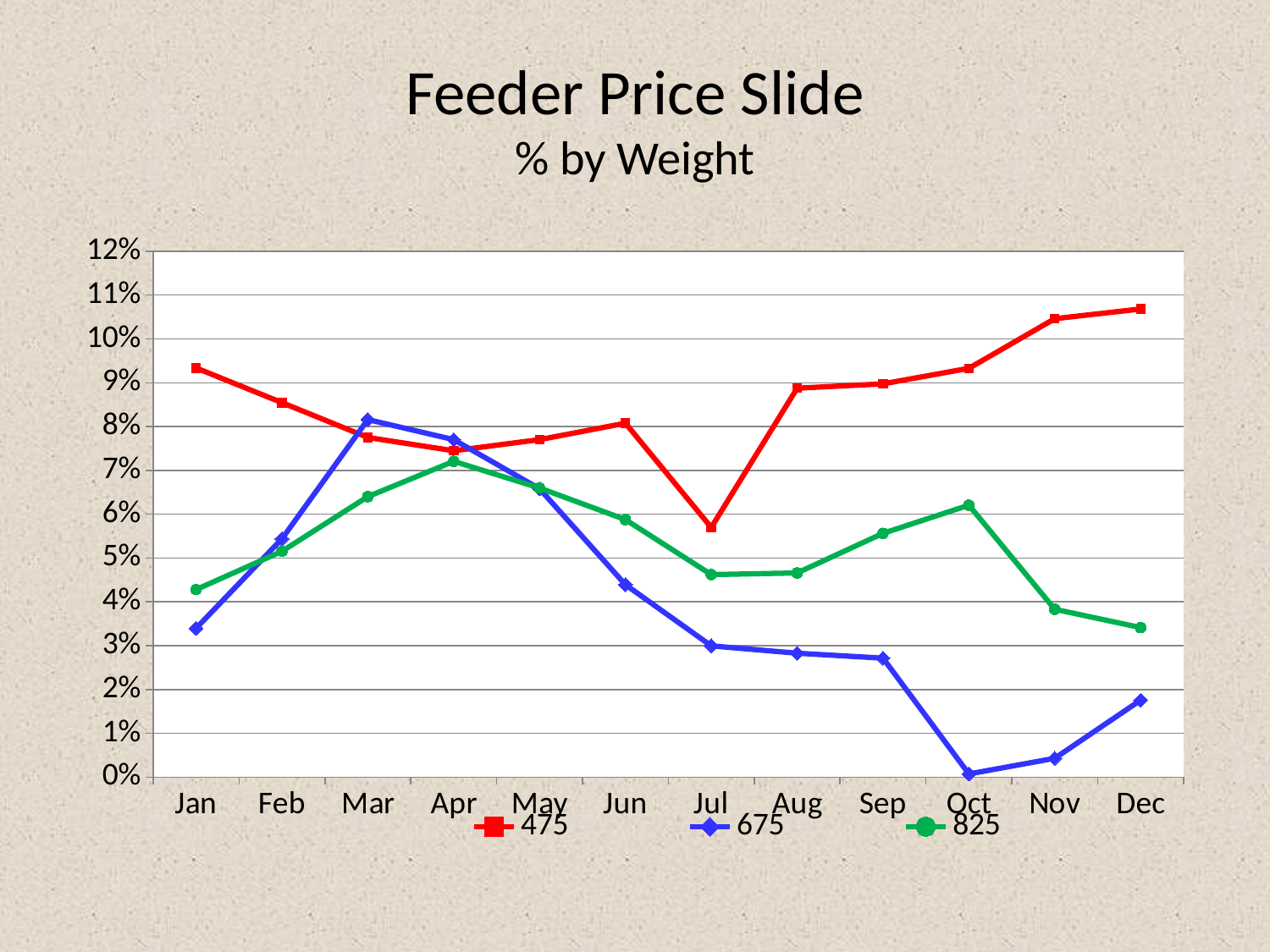
In which month does the 675 series reach its lowest value? Oct How many series does the legend list? 3 In which month does the 825 series reach its highest value? Apr What kind of chart is shown on the slide? line chart In which month does the 675 series reach its highest value? Mar In Dec, which series has the larger value, 825 or 675? 825 In which month does the 475 series reach its highest value? Dec In which month does the 475 series reach its lowest value? Jul Is the value for the 675 series in Oct greater or less than 1%? less Does the 675 series rise or fall from Mar to Oct? fall How many months are plotted along the x axis? 12 Is the value for the 475 series in Nov greater or less than 10%? greater